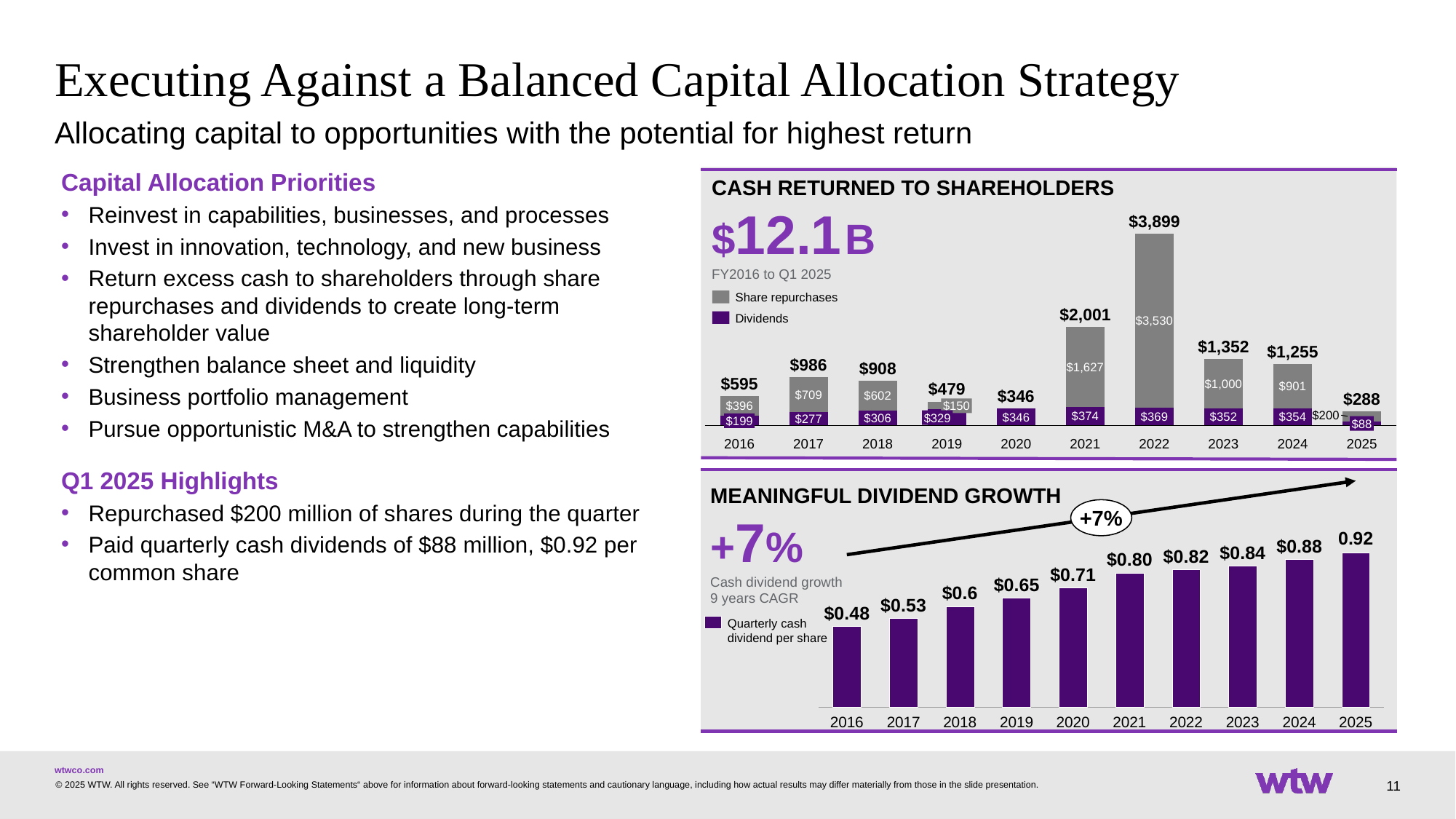
In the MEANINGFUL DIVIDEND GROWTH chart, do the values rise or fall from 2016 to 2025? rise In the CASH RETURNED TO SHAREHOLDERS chart, what is the total cash returned in 2022? $3,899 In the CASH RETURNED TO SHAREHOLDERS chart, which year has the highest total cash returned? 2022 In the MEANINGFUL DIVIDEND GROWTH chart, how many years are shown on the x axis? 10 In the CASH RETURNED TO SHAREHOLDERS chart, how many series does the legend list? 2 In the CASH RETURNED TO SHAREHOLDERS chart, is the dividends value for 2021 larger or smaller than the dividends value for 2022? larger What kind of chart is the MEANINGFUL DIVIDEND GROWTH chart? bar chart In the CASH RETURNED TO SHAREHOLDERS chart, what is the share repurchases value for 2021? $1,627 In the CASH RETURNED TO SHAREHOLDERS chart, what is the dividends value for 2018? $306 In the MEANINGFUL DIVIDEND GROWTH chart, what is the quarterly cash dividend per share for 2020? $0.71 In the CASH RETURNED TO SHAREHOLDERS chart, what is the difference between the total for 2023 and the total for 2024? $97 In the CASH RETURNED TO SHAREHOLDERS chart, which year has the lowest total cash returned? 2025